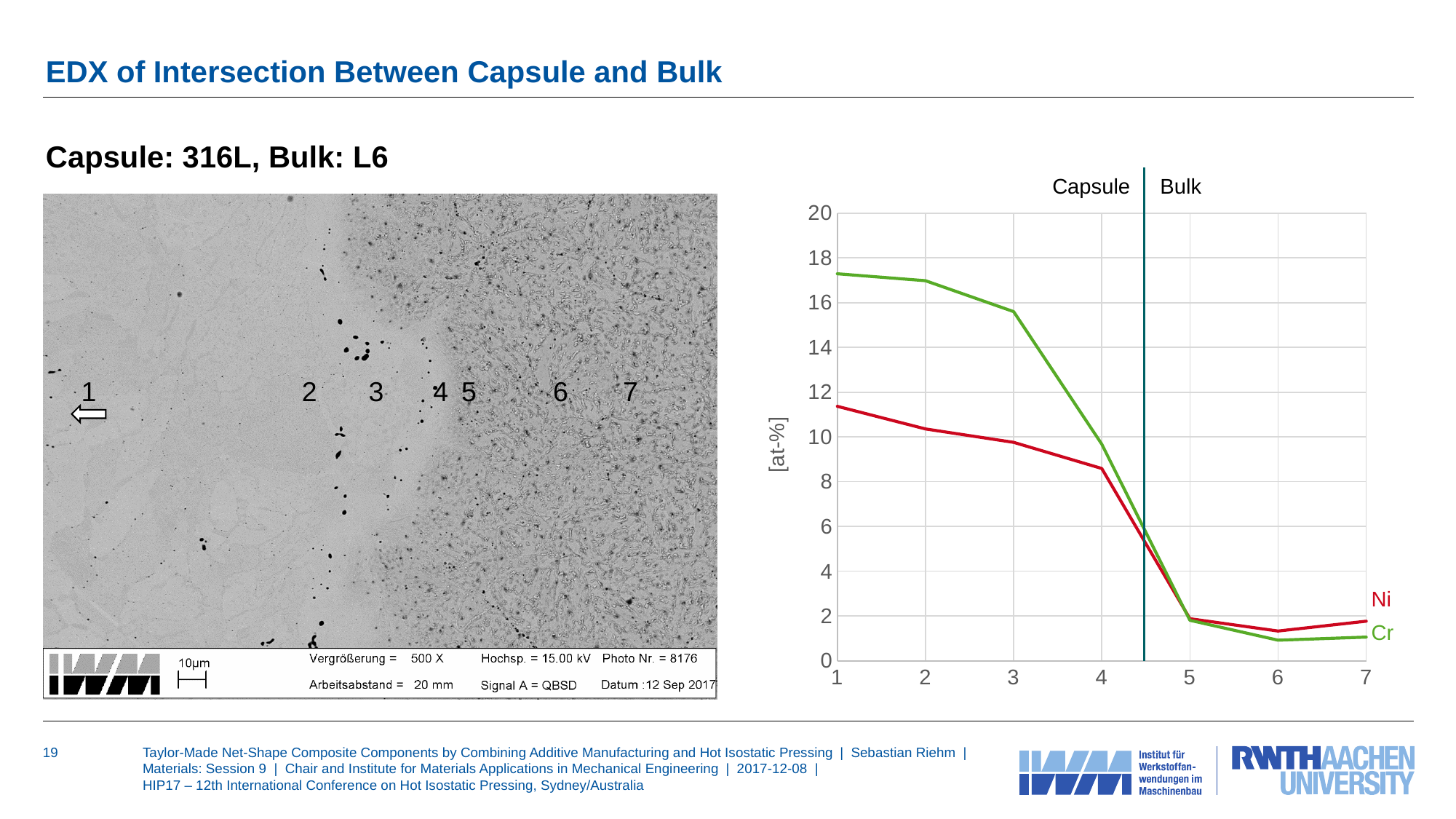
Is the Cr value at point 6 greater or less than 2? less At point 3, which series has the larger value, Ni or Cr? Cr At which point does the Cr series reach its highest value? 1 What is the label of the y axis of the chart? [at-%] Is the Cr value at point 1 greater or less than 16? greater Is the Ni value at point 4 greater or less than 8? greater How many measurement points are plotted along the x axis of the chart? 7 At point 7, which series has the larger value, Ni or Cr? Ni How many series are plotted in the chart? 2 What kind of chart is shown on the slide? line chart Do the Cr values rise or fall from point 1 to point 7? fall